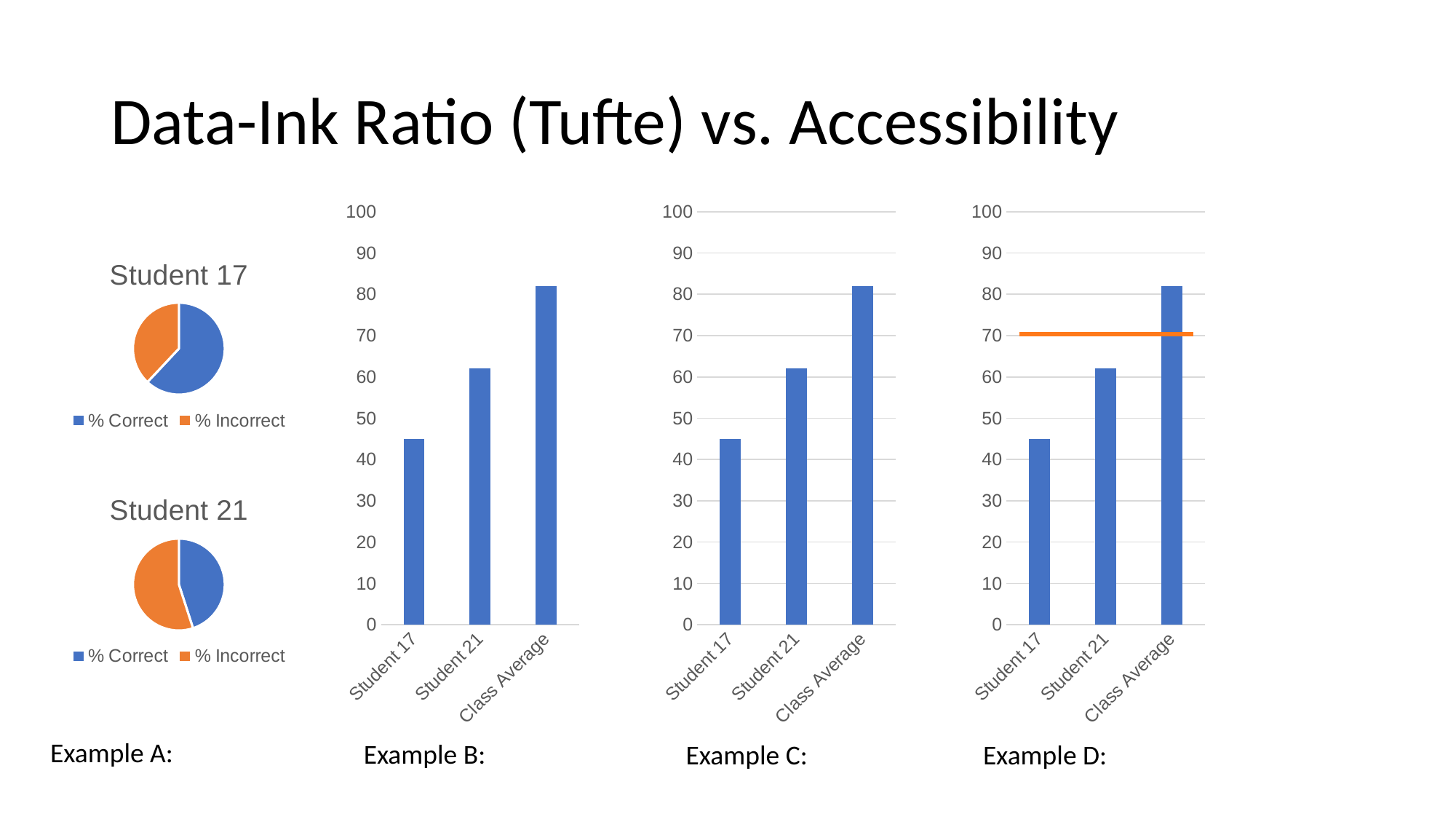
In the Example D bar chart, is the value for Student 21 greater or less than 70? less In the Example D bar chart, do the values rise or fall from Student 17 to Class Average? rise In the Example D bar chart, is the value for Student 17 greater or less than 50? less How many series does the legend of the Student 21 pie chart in Example A list? 2 In the Example C bar chart, is the value for Student 21 greater or less than 60? greater In the Example C bar chart, which category has the lowest value? Student 17 In the Student 17 pie chart in Example A, which slice is larger, % Correct or % Incorrect? % Correct In the Example B bar chart, which category has the highest value? Class Average In the Example B bar chart, which is larger, the value for Student 17 or the value for Student 21? Student 21 What kind of chart is Example B? bar chart How many categories are shown on the x axis of the Example C bar chart? 3